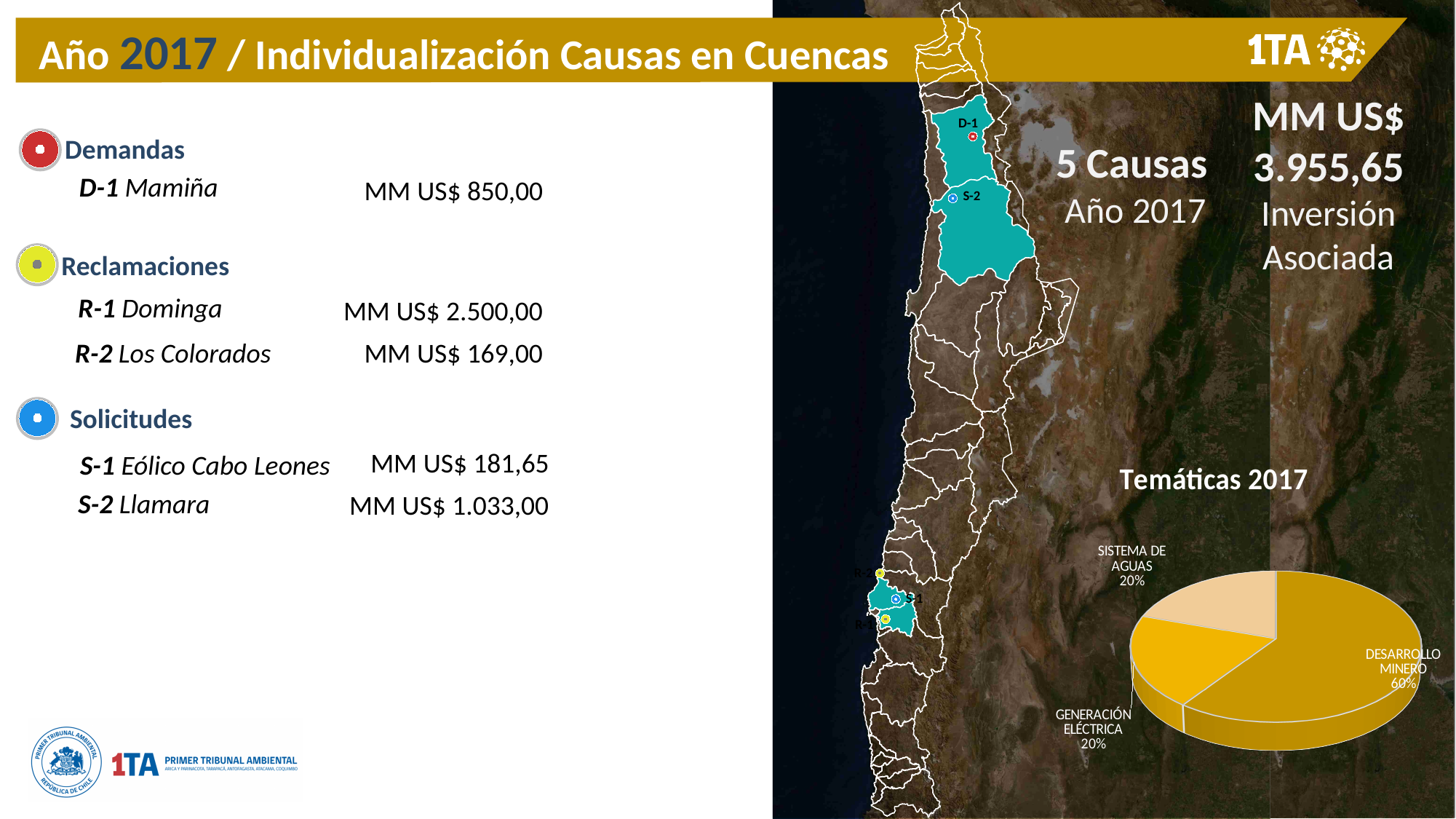
In the 'Temáticas 2017' pie chart, what share does Generación Eléctrica have? 20% What kind of chart is the 'Temáticas 2017' chart? pie chart Which category has the largest slice in the 'Temáticas 2017' pie chart? Desarrollo Minero In the 'Temáticas 2017' pie chart, what share does Desarrollo Minero have? 60% In the 'Temáticas 2017' pie chart, how many percentage points larger is Desarrollo Minero than Sistema de Aguas? 40 In the 'Temáticas 2017' pie chart, what share does Sistema de Aguas have? 20% In the 'Temáticas 2017' pie chart, which is larger: Desarrollo Minero or Generación Eléctrica? Desarrollo Minero In the 'Temáticas 2017' pie chart, do Sistema de Aguas and Generación Eléctrica have the same share? Yes How many slices does the 'Temáticas 2017' pie chart have? 3 What is the title of the pie chart on the slide? Temáticas 2017 In the 'Temáticas 2017' pie chart, what is the combined share of Sistema de Aguas and Generación Eléctrica? 40%